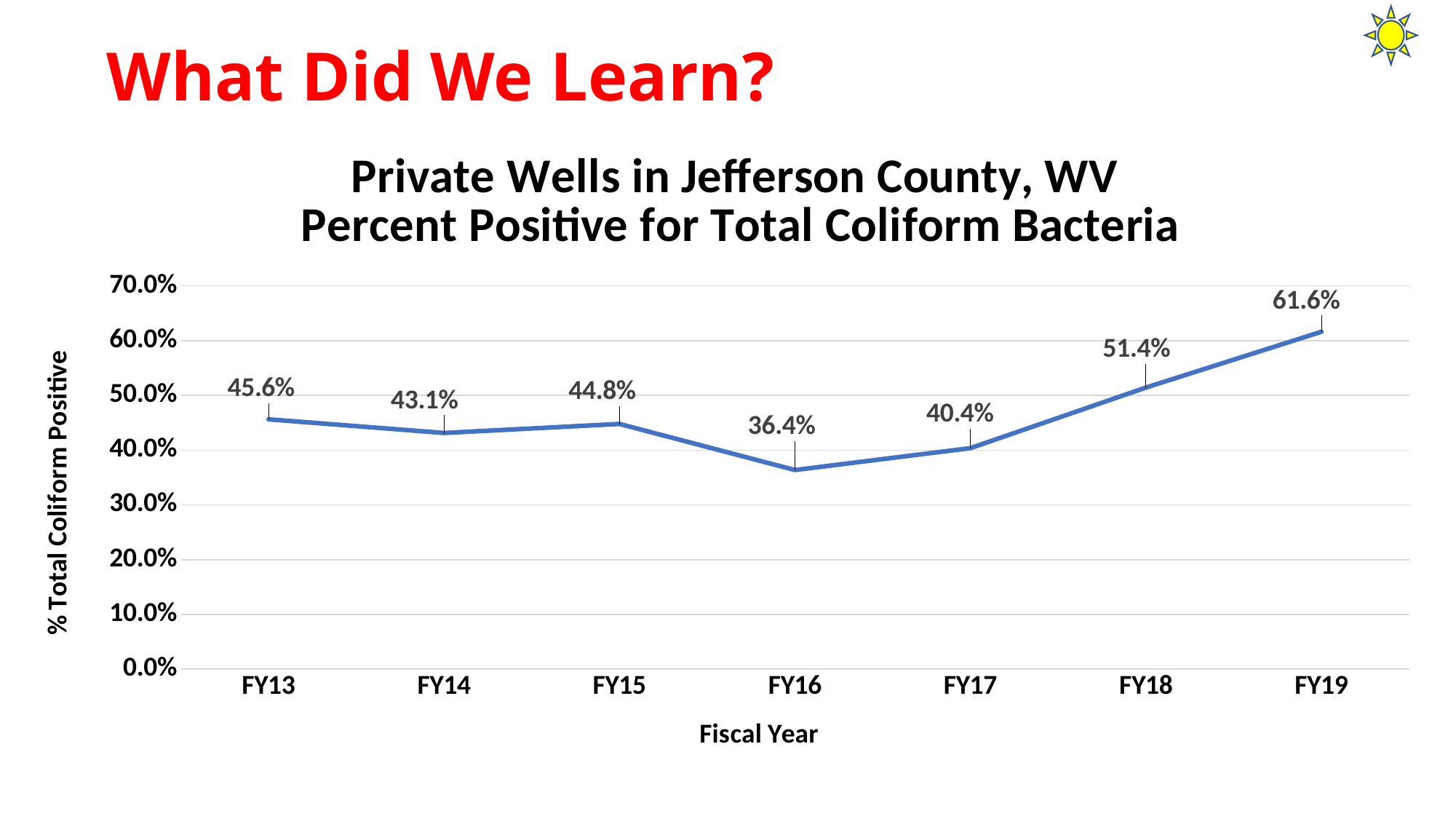
What is the percent positive for total coliform bacteria in FY13? 45.6% What kind of chart is shown on the slide? Line chart What is the label of the y axis? % Total Coliform Positive What is the percent positive for total coliform bacteria in FY16? 36.4% What is the difference in percent positive between FY19 and FY18? 10.2% Is the value for FY18 greater or less than 50.0%? greater What is the percent positive for total coliform bacteria in FY19? 61.6% What is the difference in percent positive between FY13 and FY16? 9.2% Which fiscal year has the lowest percent positive for total coliform bacteria? FY16 Which fiscal year has the highest percent positive for total coliform bacteria? FY19 Which fiscal year has a higher percent positive, FY14 or FY17? FY14 How many fiscal years are plotted on the chart? 7